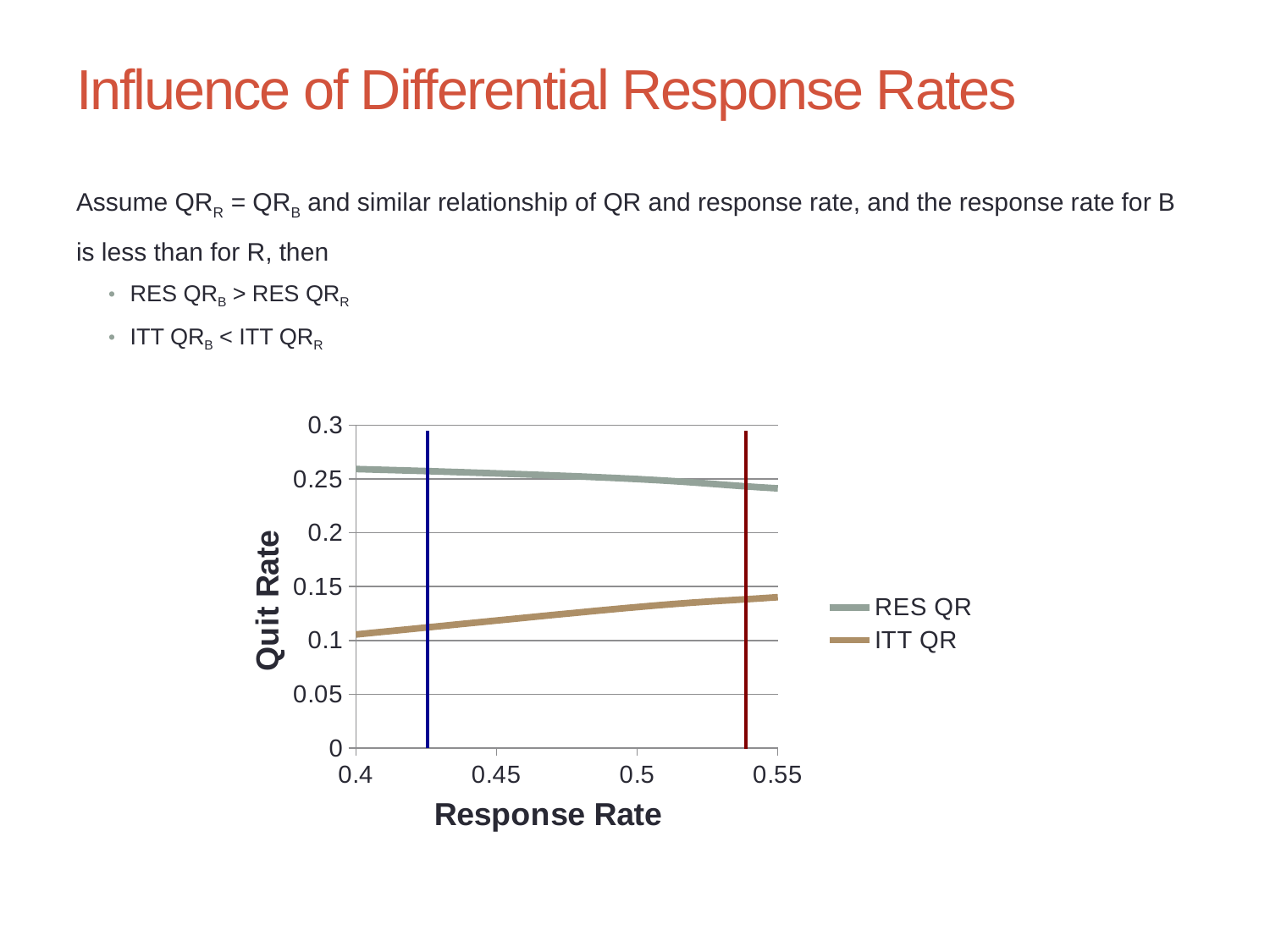
What kind of chart is shown on the slide? line chart What is the title of the chart's x axis? Response Rate Is the RES QR value at a Response Rate of 0.4 greater or less than 0.2? greater Does the ITT QR line rise or fall as Response Rate increases from 0.4 to 0.55? rise At a Response Rate of 0.5, which series has the higher Quit Rate, RES QR or ITT QR? RES QR Is the ITT QR value at a Response Rate of 0.4 greater or less than 0.15? less Is the RES QR value at a Response Rate of 0.55 greater or less than 0.3? less Which series has the lower Quit Rate across the whole Response Rate range shown? ITT QR Which two series are listed in the chart legend? RES QR and ITT QR How many series does the chart legend list? 2 Does the RES QR line rise or fall as Response Rate increases from 0.4 to 0.55? fall